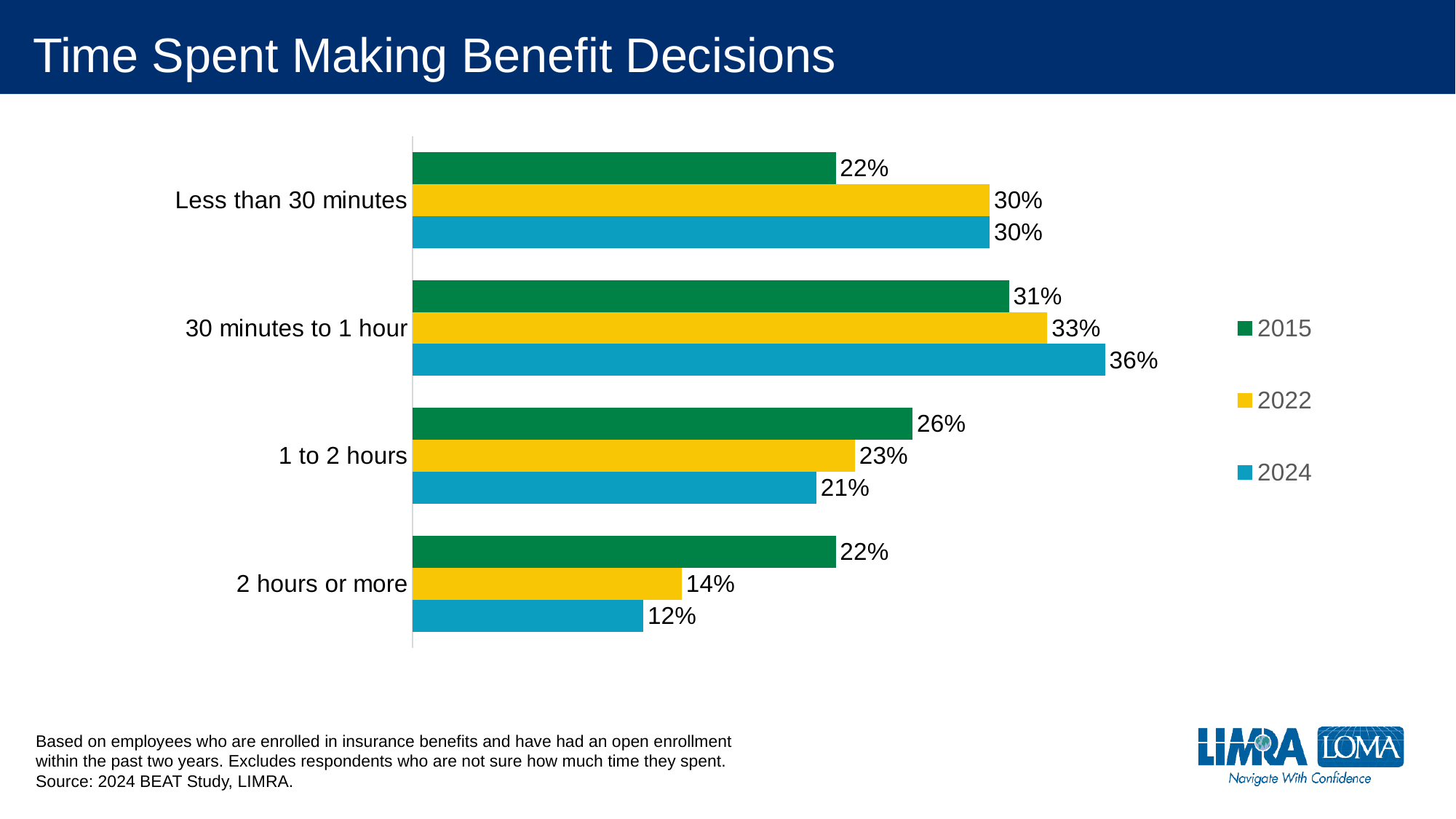
Which category has the highest value for the 2024 series? 30 minutes to 1 hour What is the difference between the 2015 and 2024 values for '2 hours or more'? 10% What is the 2015 value for the '2 hours or more' category? 22% For '1 to 2 hours', which year has the larger value, 2015 or 2024? 2015 What is the difference between the 2024 and 2015 values for 'Less than 30 minutes'? 8% How many time categories are shown on the chart? 4 What percentage of employees spent less than 30 minutes making benefit decisions in 2024? 30% How many series does the legend list? 3 Which category has the lowest value for the 2022 series? 2 hours or more Which years are listed in the chart legend? 2015, 2022, 2024 What is the 2022 value for '1 to 2 hours'? 23% What kind of chart is shown on the slide? Bar chart